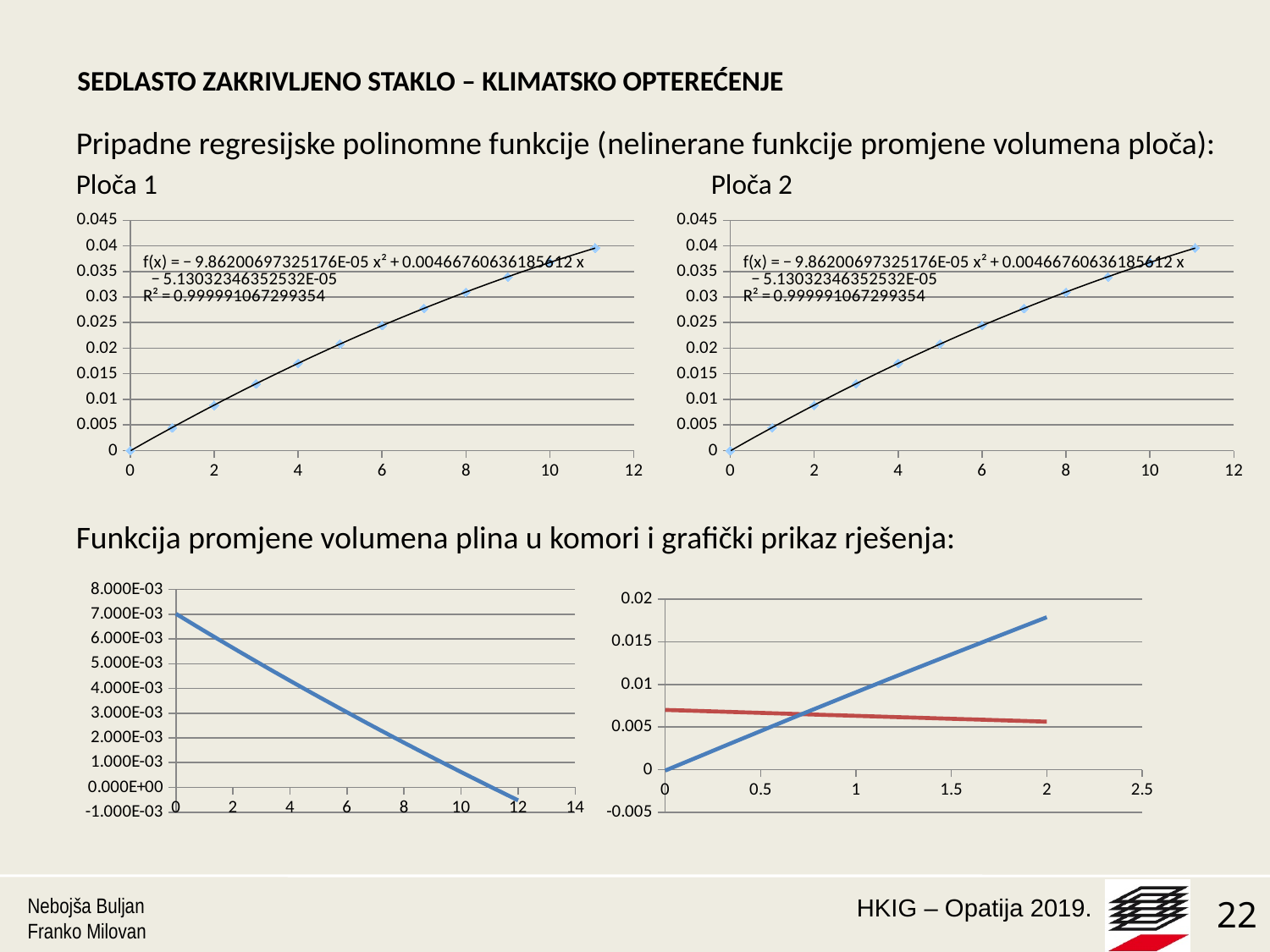
In the bottom-left chart, is the value at x = 6 greater or less than 4.000E-03? less In the bottom-left chart, do the values rise or fall as x increases? fall In the bottom-right chart, how many lines are plotted? 2 In the Ploča 1 chart, how many data points are plotted? 12 In the Ploča 2 chart, is the value at x = 4 greater or less than 0.015? greater In the Ploča 1 chart, what R² value is printed on the chart? 0.999991067299354 In the Ploča 1 chart, do the values rise or fall as x increases? rise In the Ploča 2 chart, which point has the highest value, x = 0 or x = 11? x = 11 In the Ploča 1 chart, is the value at x = 11 greater or less than 0.035? greater In the bottom-right chart, at x = 2, which line has the larger value, the blue line or the red line? the blue line In the Ploča 1 chart, what kind of chart is shown? scatter chart with a fitted curve